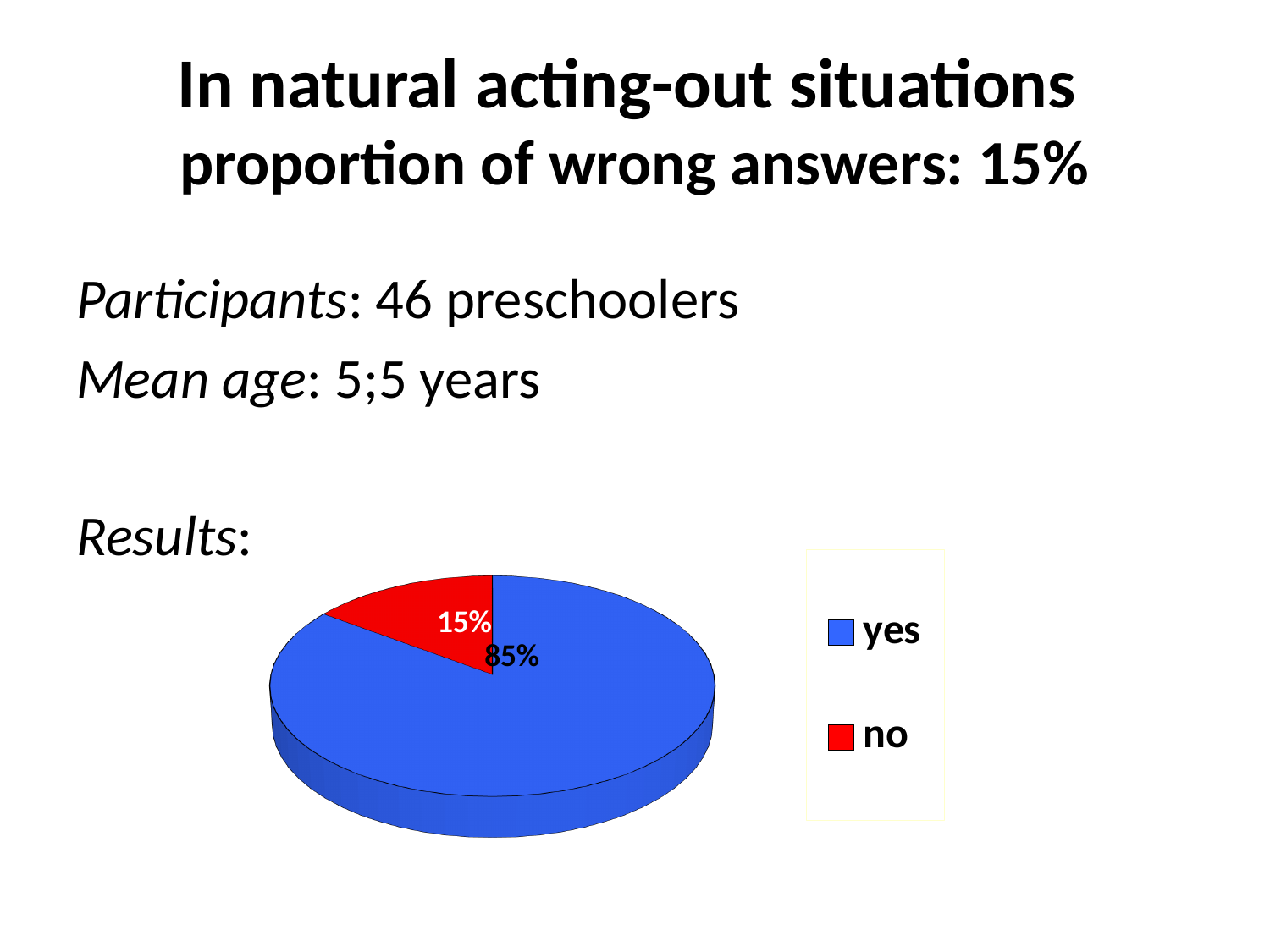
Which is larger, the "yes" slice or the "no" slice? yes What share of the pie does the "yes" slice represent? 85% What kind of chart is shown on the slide? pie chart How many entries does the legend list? 2 What colour is the "no" slice in the pie chart? red What is the difference in percentage points between the "yes" and "no" slices? 70 percentage points Which slice of the pie is the smallest? no What share of the pie does the "no" slice represent? 15% What colour is the "yes" slice in the pie chart? blue How many slices does the pie chart have? 2 Which slice of the pie is the largest? yes